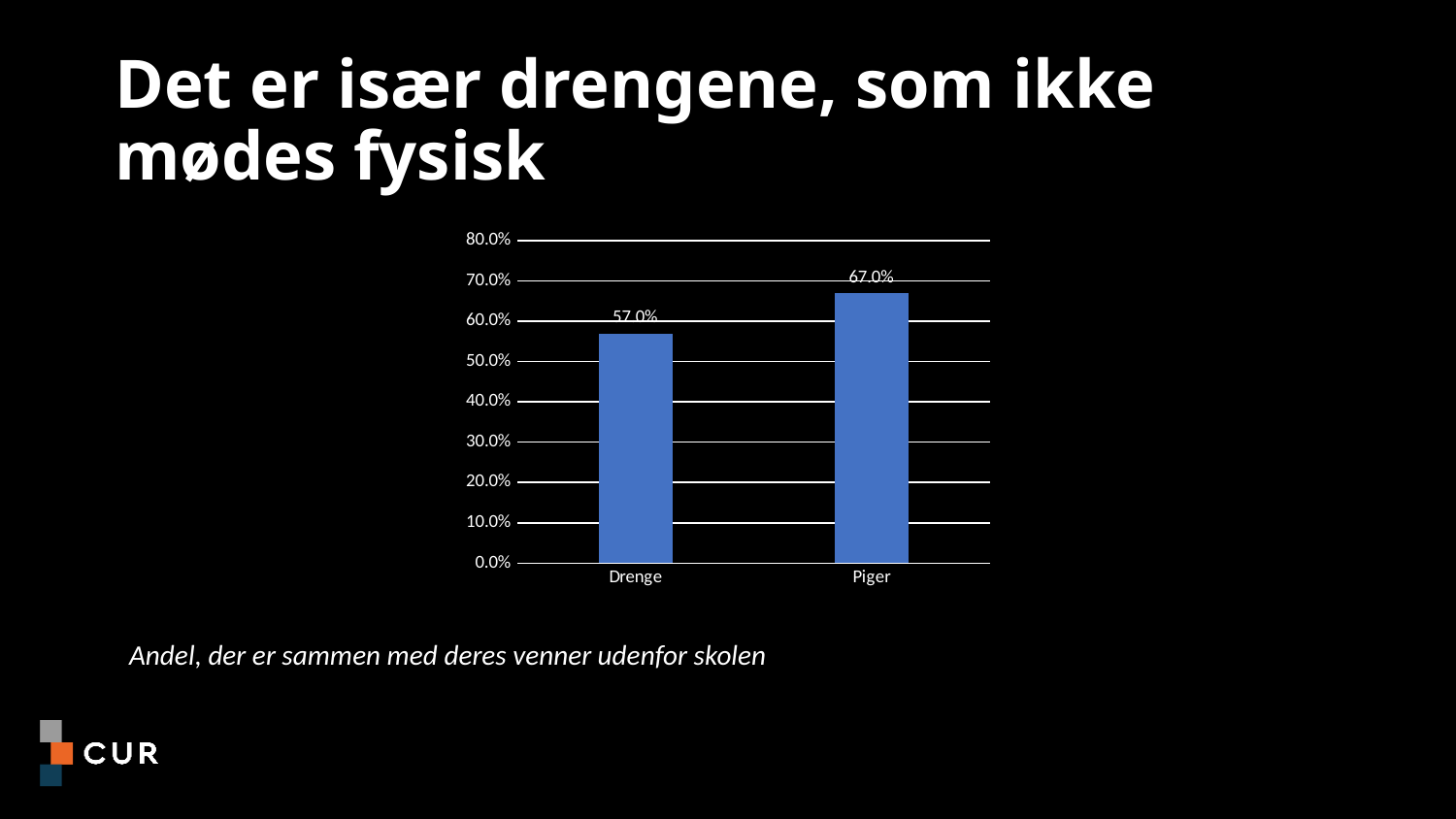
Which is larger, the value for Drenge or the value for Piger? Piger What is the highest value shown on the y axis? 80.0% What is the value for Drenge? 57.0% Which category has the lowest value? Drenge What is the difference between the values for Piger and Drenge? 10.0% What is the value for Piger? 67.0% Is the value for Piger greater or less than 60.0%? greater What kind of chart is shown on the slide? Bar chart What colour are the bars in the chart? Blue Which category has the highest value? Piger How many categories are shown on the x axis? 2 Is the value for Drenge greater or less than 60.0%? less